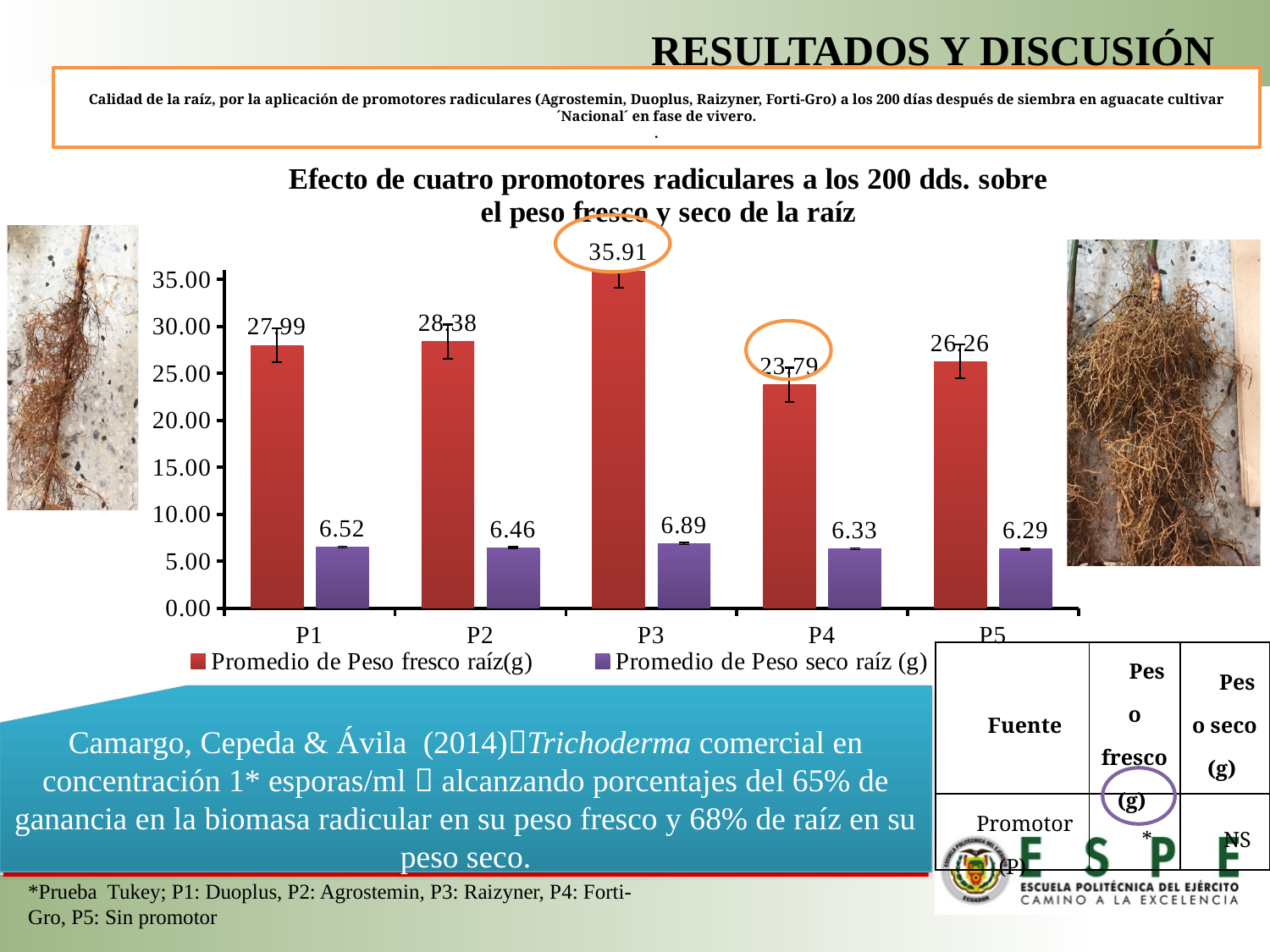
What is the average dry root weight (Promedio de Peso seco raíz) for P1? 6.52 Which treatment has the lowest average fresh root weight? P4 What is the average fresh root weight (Promedio de Peso fresco raíz) for P3? 35.91 How many series does the legend list? 2 What is the average fresh root weight for P4? 23.79 How many treatments (categories) are shown on the x axis? 5 What is the difference in average fresh root weight between P3 and P4? 12.12 What kind of chart is shown on the slide? Bar chart What colour are the bars for Promedio de Peso seco raíz (g)? Purple Which is larger, the average fresh root weight for P2 or for P5? P2 Which treatment has the lowest average dry root weight? P5 Which treatment has the highest average fresh root weight? P3